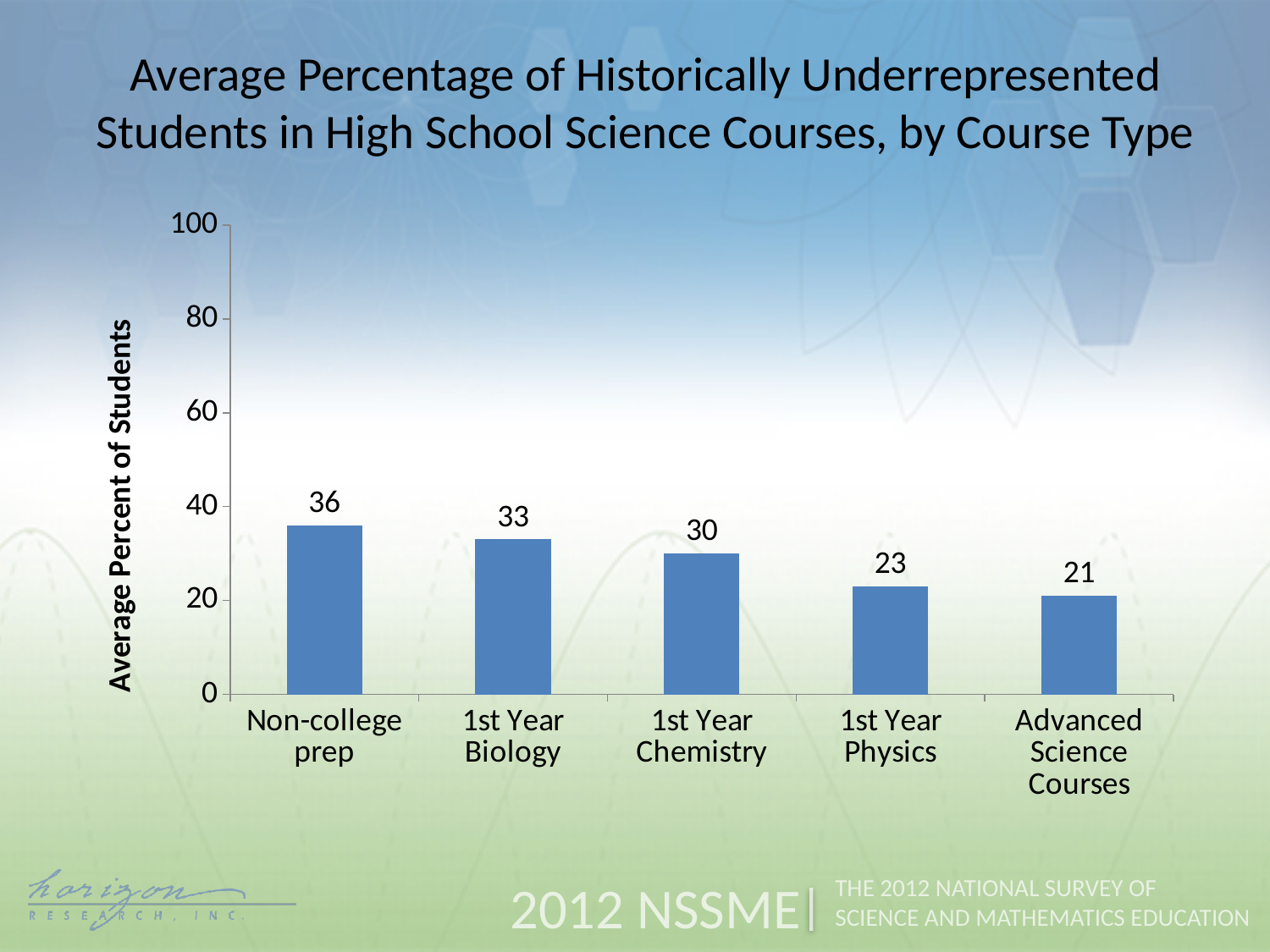
Which course type has the lowest average percent of historically underrepresented students? Advanced Science Courses What is the difference between the values for 1st Year Biology and 1st Year Physics? 10 What is the label of the vertical axis? Average Percent of Students What is the average percent of historically underrepresented students in Non-college prep courses? 36 Which course type has the highest average percent of historically underrepresented students? Non-college prep What kind of chart is shown on the slide? bar chart Do the values rise or fall moving from left to right across the course types? fall How many course types are shown on the chart? 5 What is the value shown for 1st Year Chemistry? 30 Is the value for Non-college prep greater or less than 40? less What is the value shown for Advanced Science Courses? 21 Which is larger, the value for 1st Year Chemistry or the value for 1st Year Physics? 1st Year Chemistry